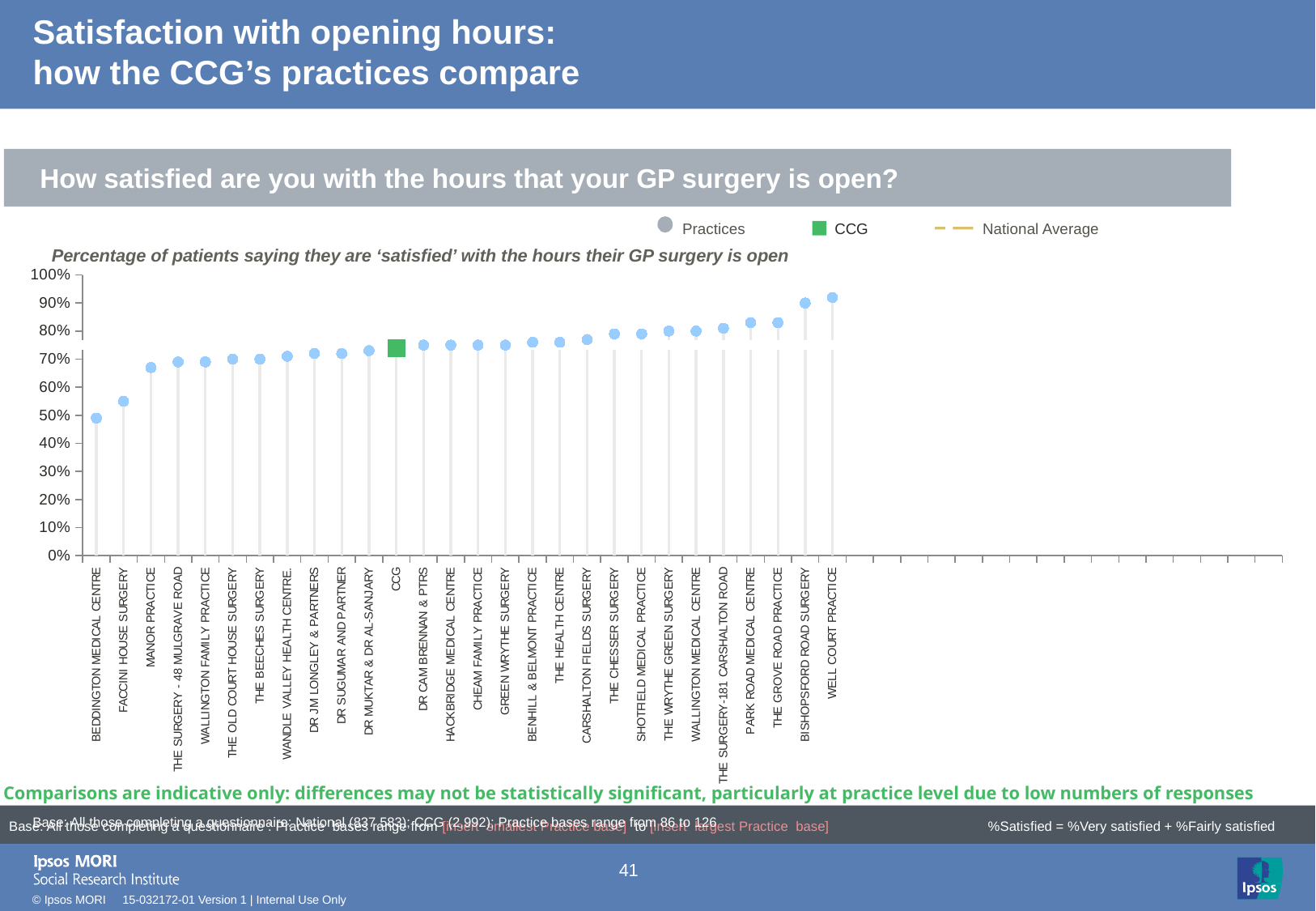
What colour is the marker used for the CCG? Green Is the value for Park Road Medical Centre greater or less than 80%? greater Is the value for Faccini House Surgery greater or less than 50%? greater Do the values rise or fall moving from left to right along the x axis? rise Which practice has the highest percentage of patients satisfied with opening hours? Well Court Practice Is the value for CCG greater or less than 80%? less What kind of chart is shown on the slide? Dot (marker) chart Which has the larger value, Beddington Medical Centre or Faccini House Surgery? Faccini House Surgery Which practice has the lowest percentage of patients satisfied with opening hours? Beddington Medical Centre How many entries does the legend list? 3